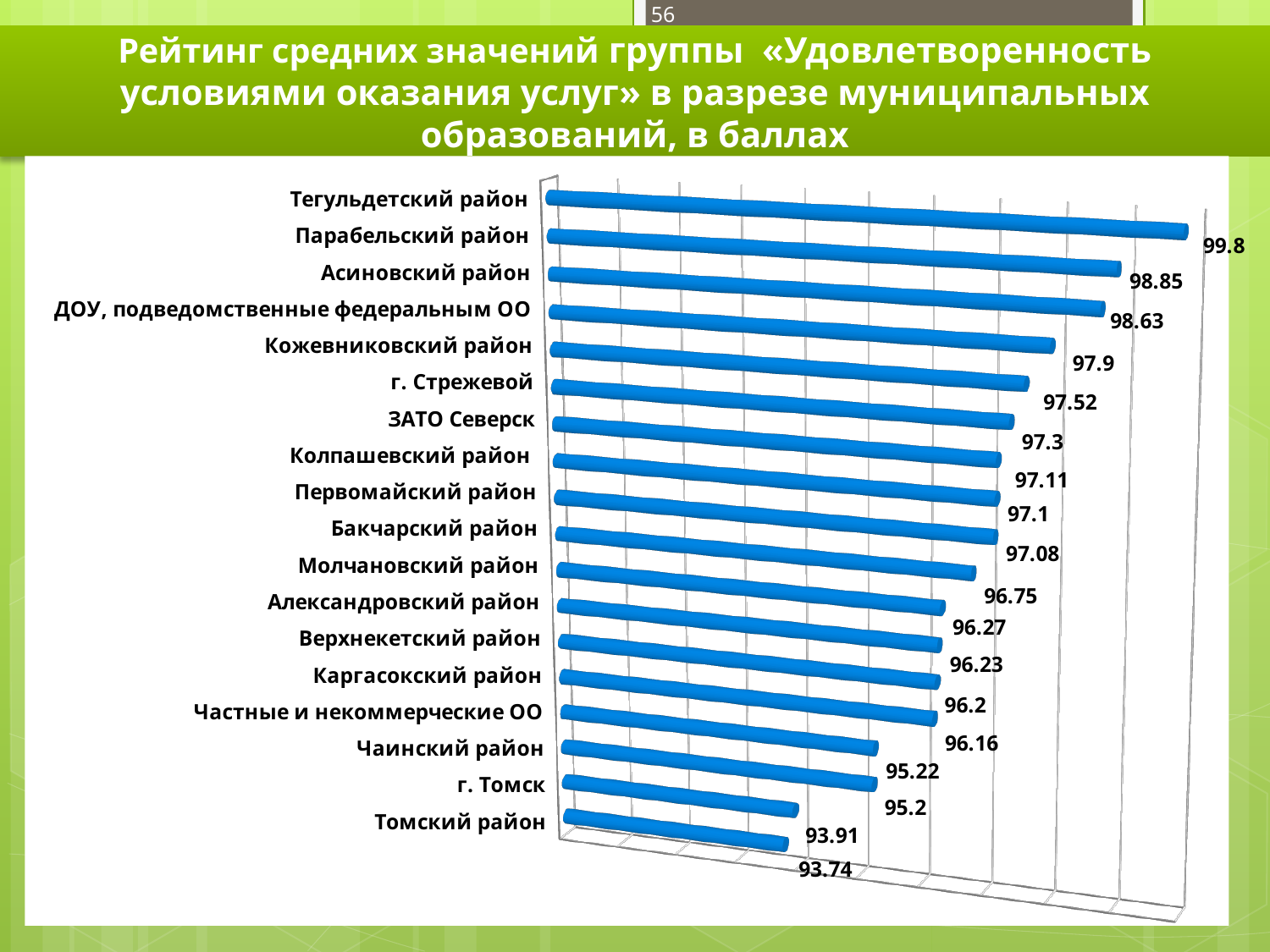
What is the difference between the values for Парабельский район and Асиновский район? 0.22 Which category has the lowest value? Томский район How many municipal entities (categories) are shown in the chart? 18 What kind of chart is shown on the slide? bar chart Which has a larger value, Кожевниковский район or Чаинский район? Кожевниковский район What is the value for г. Томск? 93.91 What is the value for Частные и некоммерческие ОО? 95.22 What is the difference between the values for Тегульдетский район and Томский район? 6.06 What is the value for ДОУ, подведомственные федеральным ОО? 97.9 Do the values rise or fall going from the top category to the bottom category? fall Which category has the highest value? Тегульдетский район What is the value for Тегульдетский район? 99.8